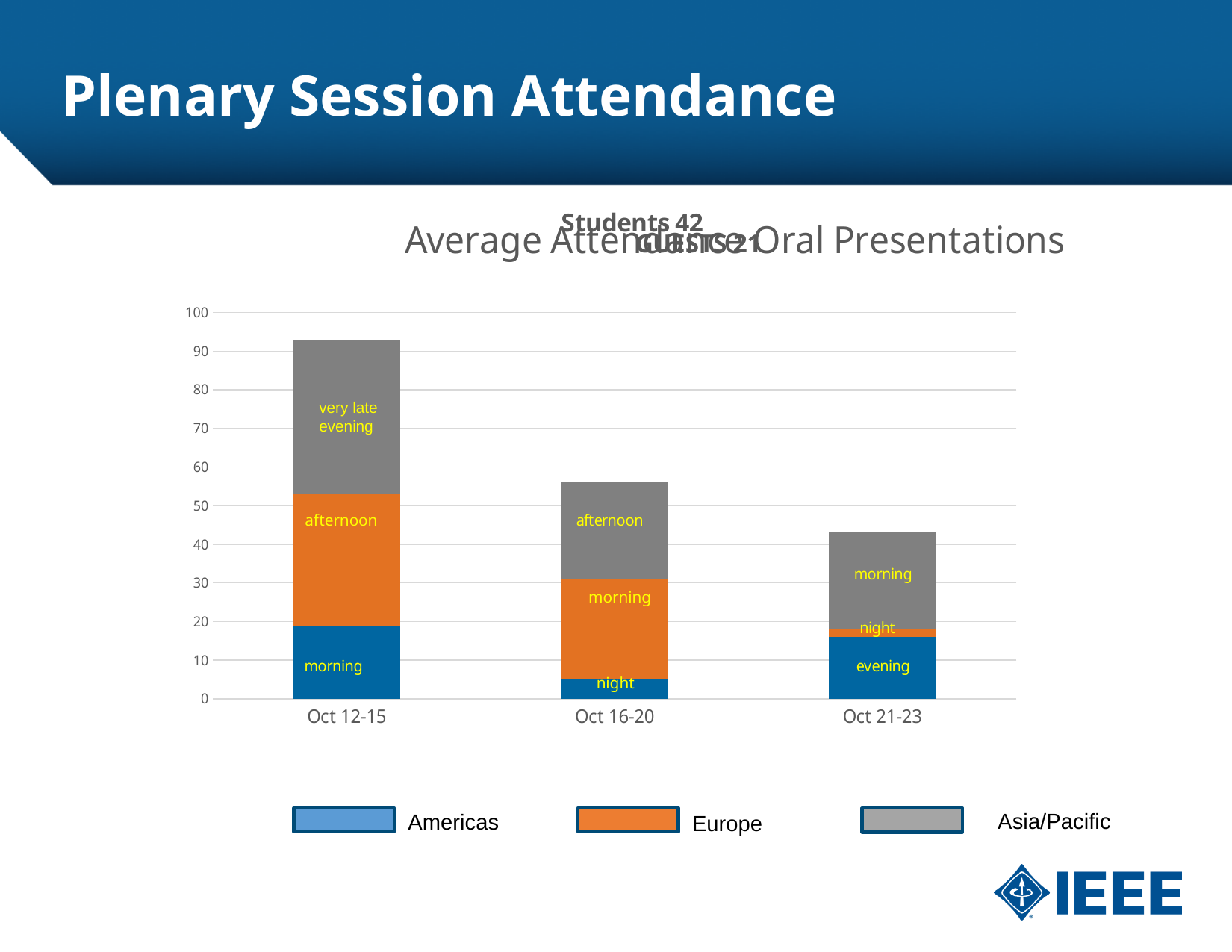
Which date range has the tallest stacked bar? Oct 12-15 How many series does the chart's legend list? 3 How many date ranges are shown on the x axis of the chart? 3 What are the three series listed in the chart's legend? Americas, Europe, Asia/Pacific Is the total height of the Oct 12-15 bar greater or less than 80? greater Which date range has the shortest stacked bar? Oct 21-23 Is the total height of the Oct 16-20 bar greater or less than 50? greater What kind of chart is shown on the slide? Stacked bar chart Is the total height of the Oct 21-23 bar greater or less than 50? less Which series is shown in orange in the legend? Europe Which stacked bar is taller, Oct 16-20 or Oct 21-23? Oct 16-20